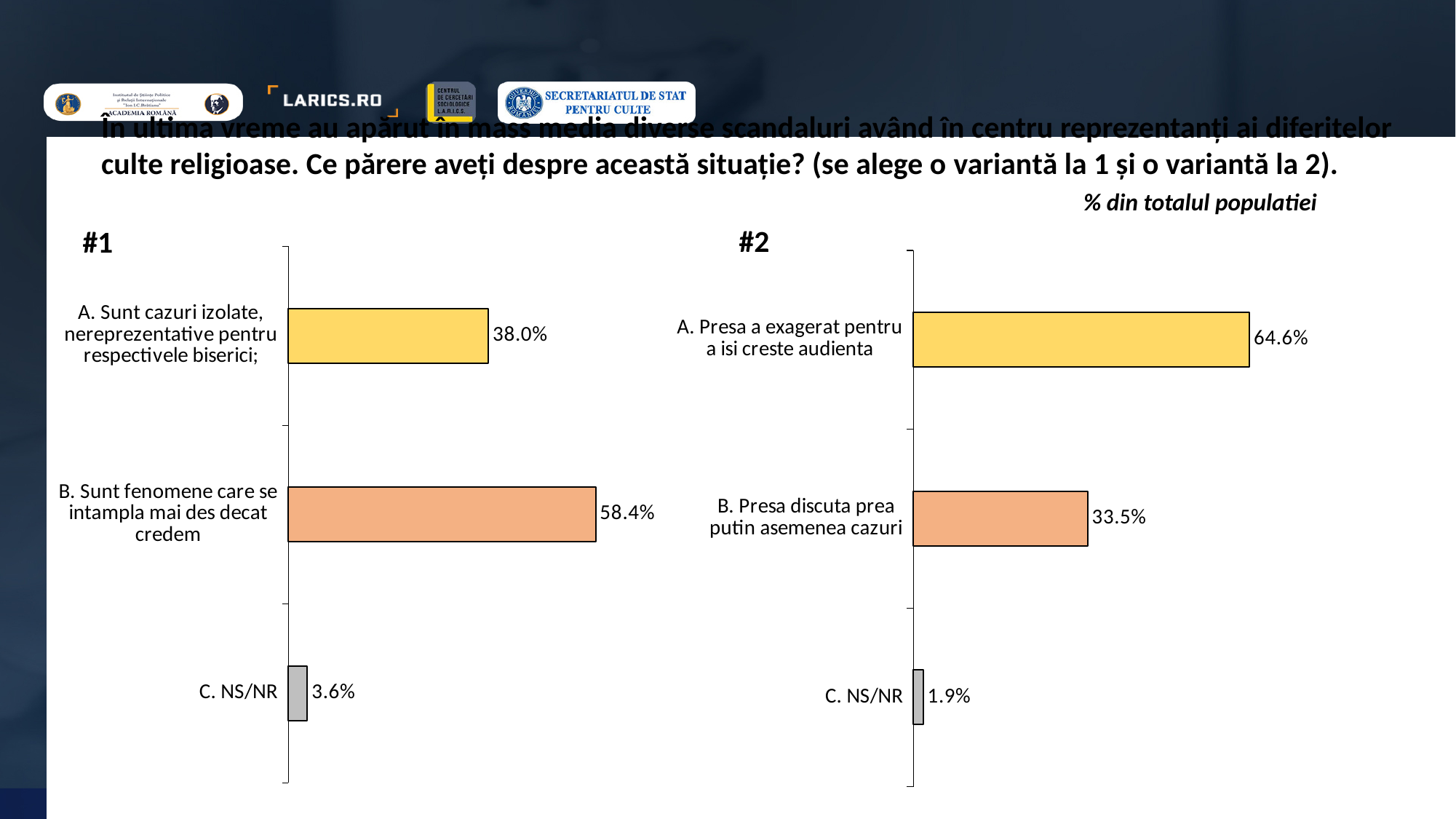
What unit note is shown above the charts on the right side of the slide? % din totalul populatiei In chart #2, which is larger: the value for option A or the value for option B? A. Presa a exagerat pentru a isi creste audienta In chart #1, what is the value for 'C. NS/NR'? 3.6% What kind of chart is chart #2? Bar chart In chart #2, which category has the lowest value? C. NS/NR In chart #2, what is the difference between the values for option A and option B? 31.1% In chart #1, which category has the highest value? B. Sunt fenomene care se intampla mai des decat credem In chart #1, what is the difference between the values for option B and option A? 20.4% In chart #1, what is the value for 'B. Sunt fenomene care se intampla mai des decat credem'? 58.4% In chart #2, what is the value for 'B. Presa discuta prea putin asemenea cazuri'? 33.5% In chart #2, what is the value for 'A. Presa a exagerat pentru a isi creste audienta'? 64.6% How many categories are shown in chart #1? 3